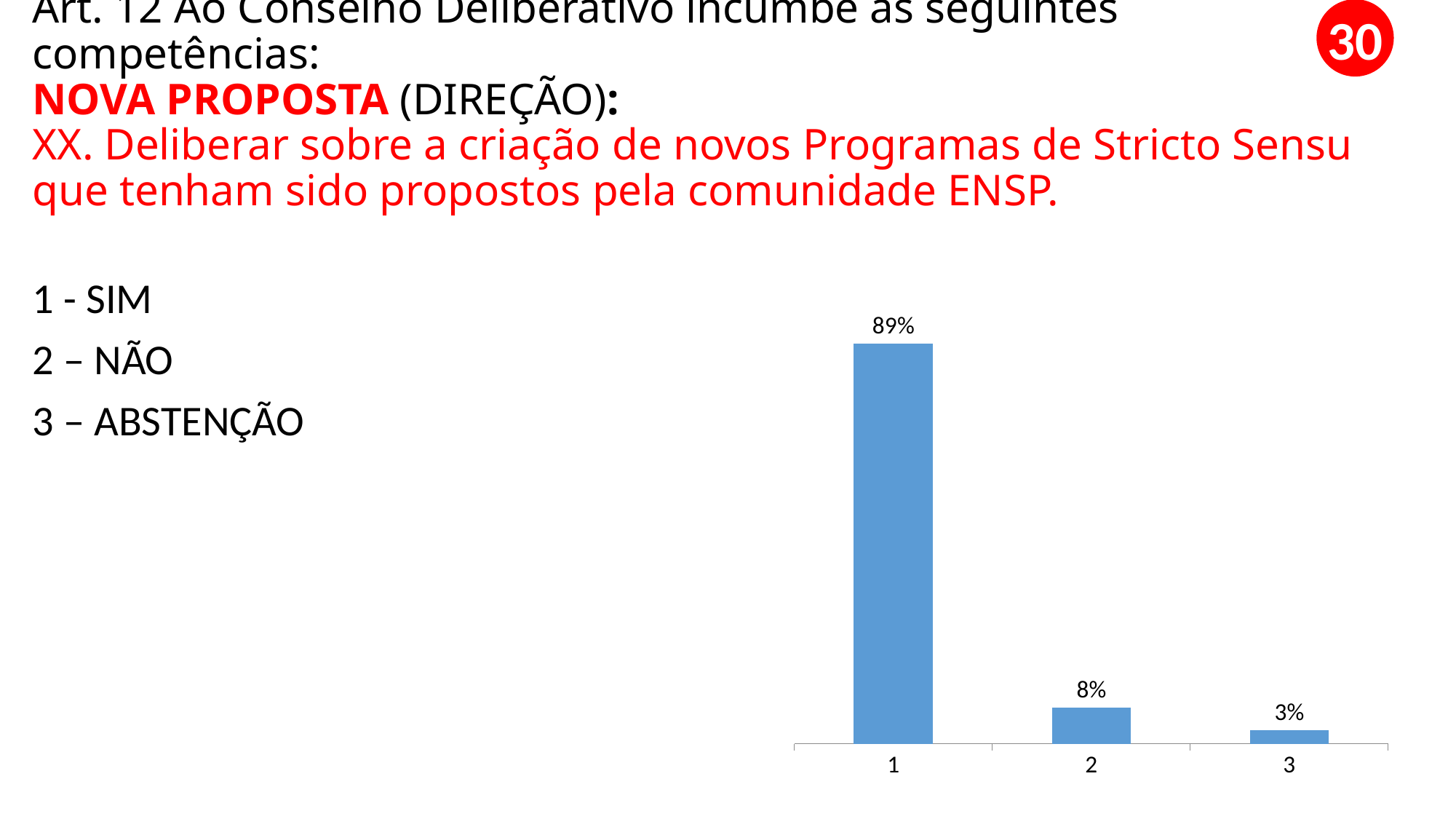
How many categories are shown on the x axis? 3 What is the difference between the values for category 2 and category 3? 5% Which category has the lowest value? 3 What is the value shown for category 3? 3% What is the value shown for category 1? 89% What is the value shown for category 2? 8% What kind of chart is shown on the slide? bar chart What colour are the bars in the chart? blue Do the values rise or fall from category 1 to category 3? fall Which category has the highest value? 1 Which is larger, the value for category 2 or the value for category 3? 2 What is the difference between the values for category 1 and category 2? 81%